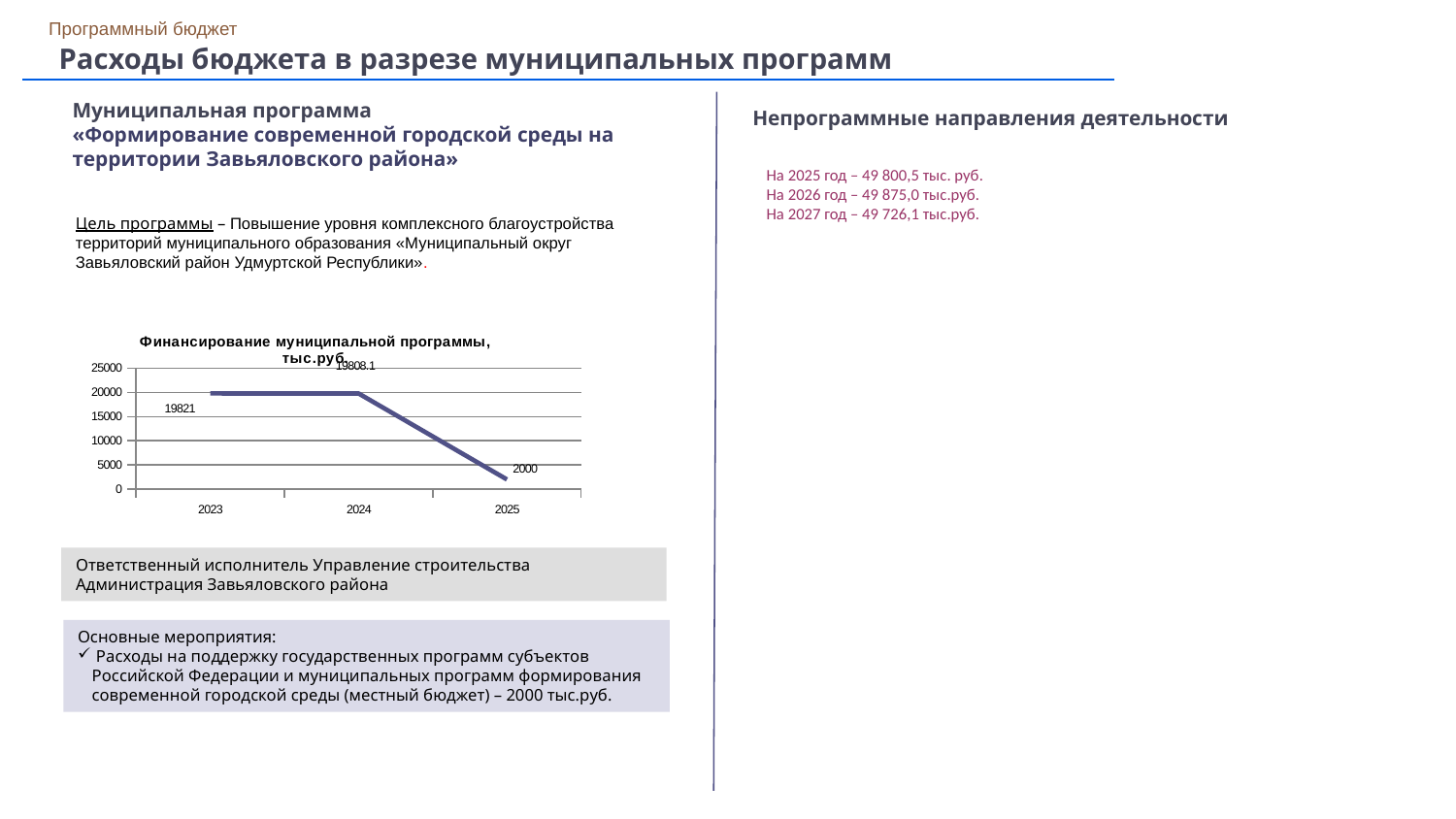
What is the value for 2024 in the chart? 19808.1 How many years are plotted on the x axis of the chart? 3 Is the value for 2025 greater or less than 5000? less What is the value for 2023 in the chart? 19821 What is the difference between the values for 2024 and 2025? 17808.1 What is the title of the chart on the slide? Финансирование муниципальной программы, тыс.руб. What is the difference between the values for 2023 and 2025? 17821 Do the values in the chart rise or fall from 2023 to 2025? fall Which year has the lowest value in the chart? 2025 Which is larger, the value for 2024 or the value for 2025? 2024 What type of chart is shown on the slide? line chart What is the value for 2025 in the chart? 2000